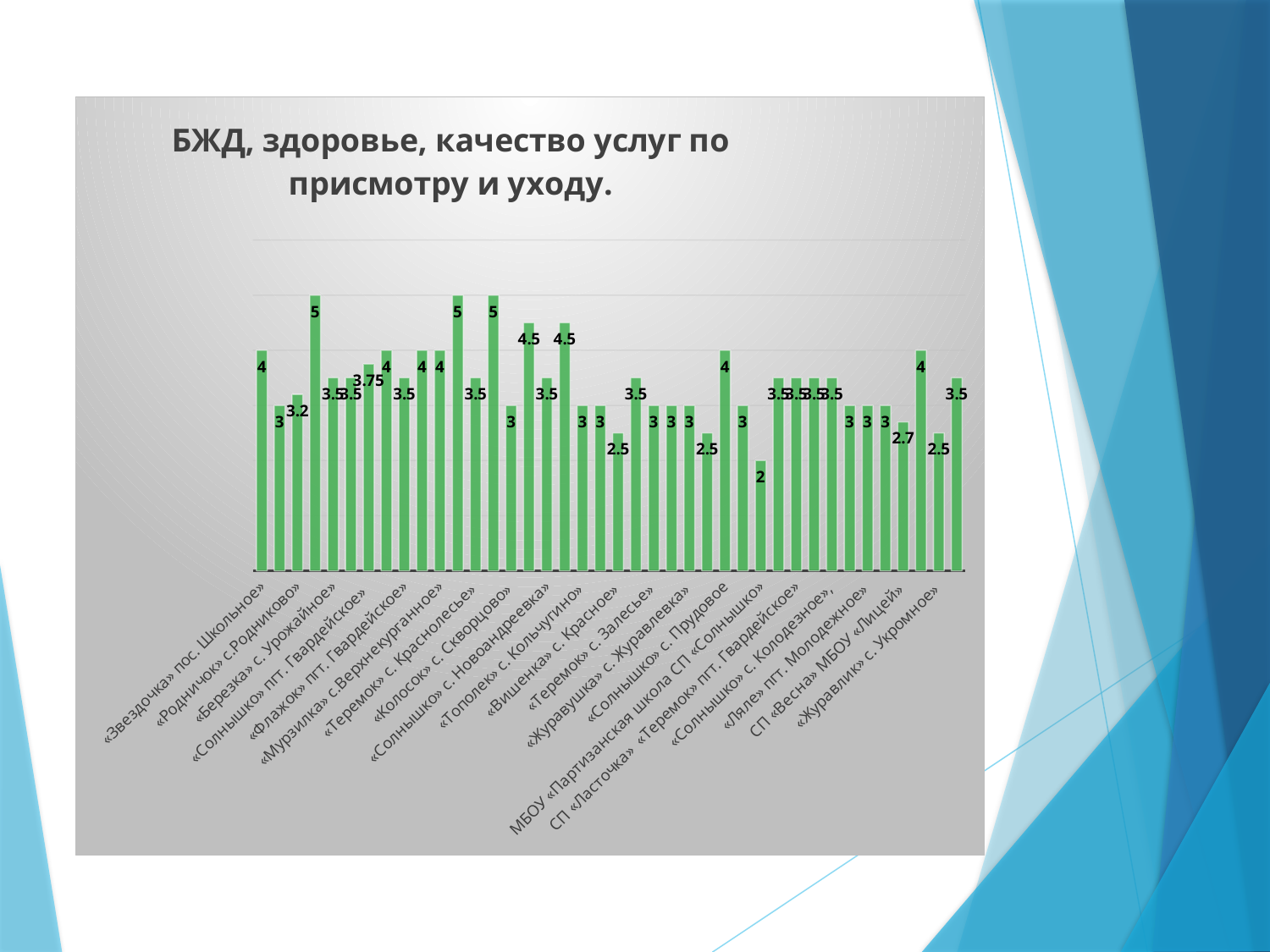
What is the title of the chart? БЖД, здоровье, качество услуг по присмотру и уходу. What kind of chart is shown on the slide? bar chart Is the value of the leftmost bar greater or less than the value of the rightmost bar? greater What colour are the bars in the chart? green What is the value of the second bar from the left in the chart? 3 How many bars in the chart have a value of 4.5? 2 What is the lowest value shown on any bar in the chart? 2 How many bars in the chart have a value of 5? 3 What is the difference between the highest bar value (5) and the lowest bar value (2)? 3 What is the value of the leftmost bar in the chart? 4 What is the value of the rightmost bar in the chart? 3.5 What is the highest value shown on any bar in the chart? 5